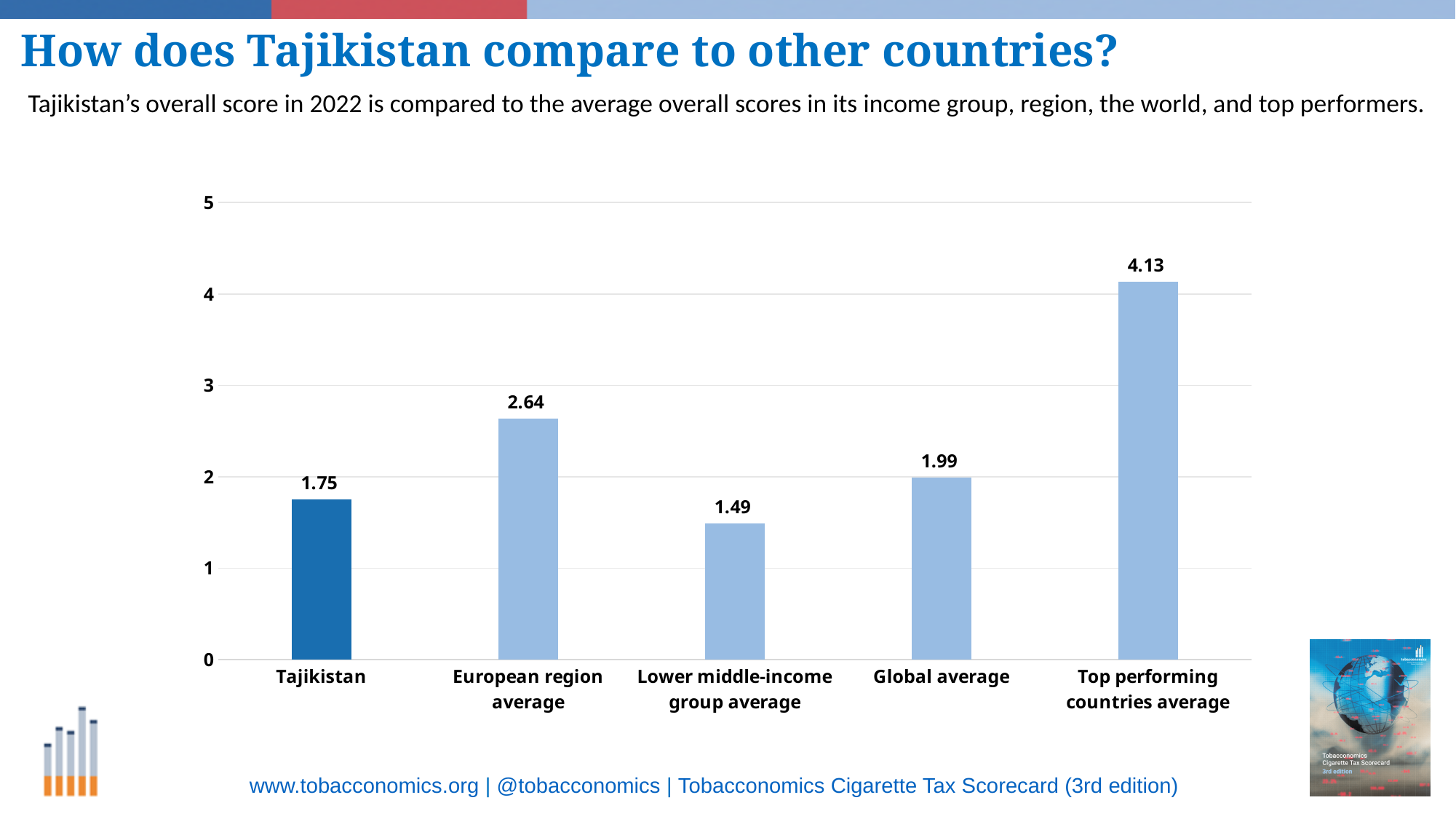
How many categories are shown on the chart? 5 What is the value shown for the Lower middle-income group average? 1.49 What is the value shown for the Global average? 1.99 Which is larger, Tajikistan's score or the Global average? Global average What is the difference between the Top performing countries average and Tajikistan's score? 2.38 What is the difference between the European region average and the Global average? 0.65 Is the value for the European region average greater or less than 3? less What kind of chart is shown on the slide? Bar chart What is the value shown for the European region average? 2.64 Which category has the lowest value? Lower middle-income group average What is the overall score shown for Tajikistan? 1.75 Which category has the highest value? Top performing countries average